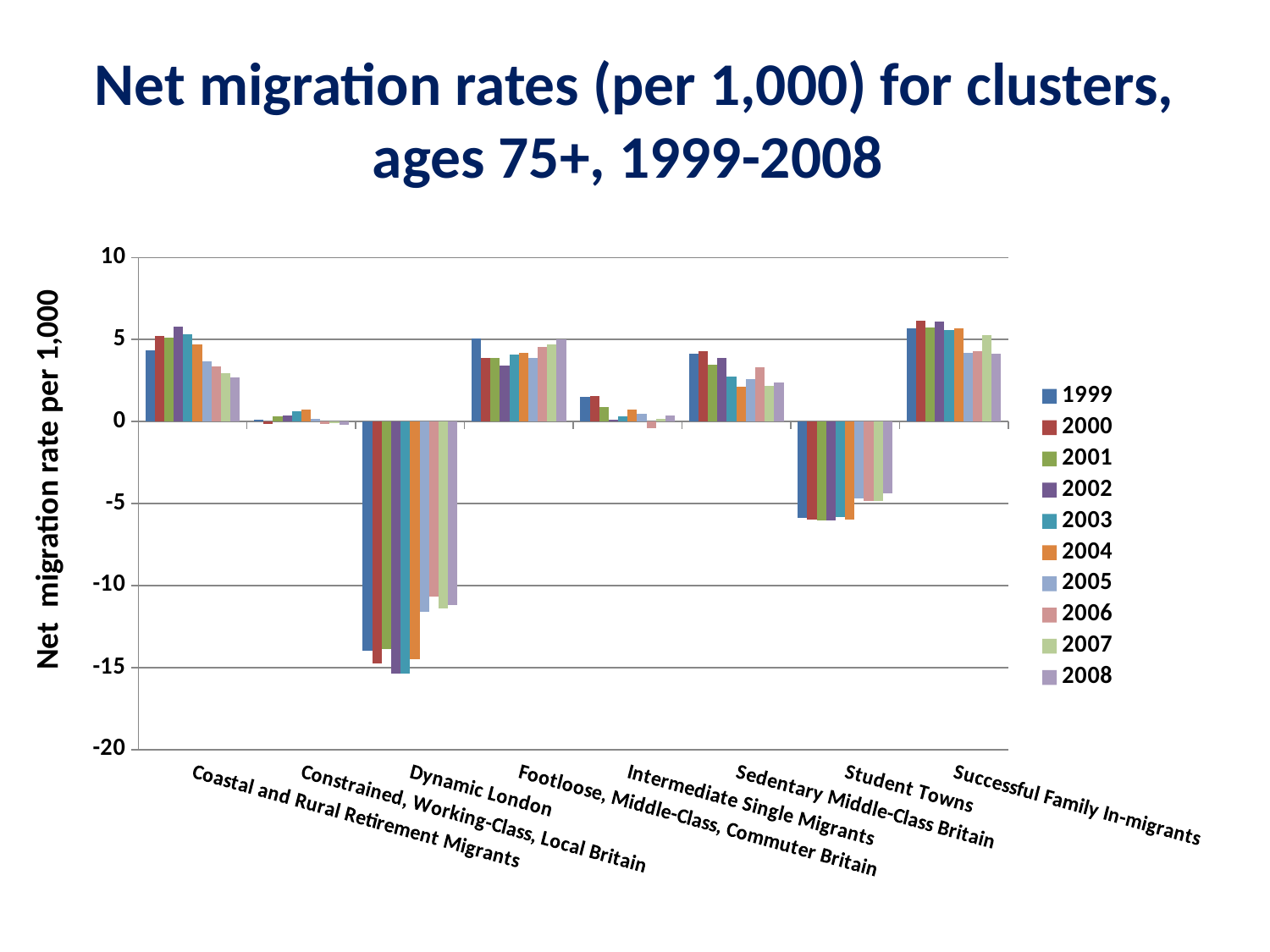
Is the value for Successful Family In-migrants in 2000 greater or less than 5? greater How many cluster categories are shown along the x axis? 8 How many series (years) does the legend list? 10 Which is larger, the 2008 value for Footloose, Middle-Class, Commuter Britain or the 2008 value for Intermediate Single Migrants? Footloose, Middle-Class, Commuter Britain What is the label on the vertical axis? Net migration rate per 1,000 Which is larger, the 1999 value for Dynamic London or the 1999 value for Student Towns? Student Towns Do the values for Coastal and Rural Retirement Migrants rise or fall from 2002 to 2008? fall What kind of chart is shown on the slide? Bar chart Do the values for Student Towns rise or fall from 2004 to 2008? rise Is the value for Coastal and Rural Retirement Migrants in 2008 greater or less than 5? less Is the value for Dynamic London in 2004 greater or less than -10? less Which cluster has the lowest net migration rates across all years? Dynamic London